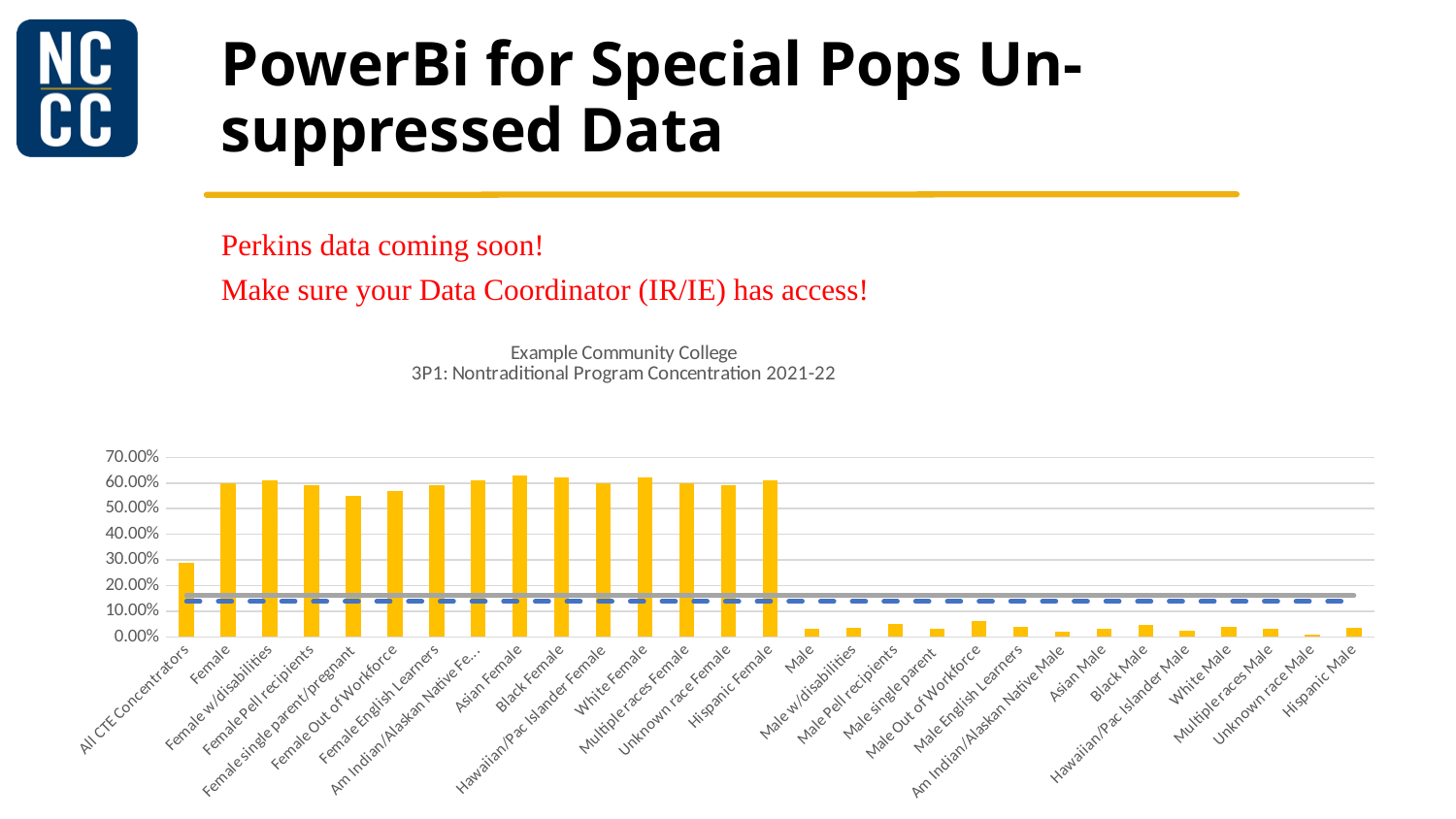
How many categories are plotted along the x axis of the chart? 29 Which is larger, the value for Female or the value for Male? Female Is the value for Male Out of Workforce greater or less than 10.00%? less What is the title of the chart? Example Community College 3P1: Nontraditional Program Concentration 2021-22 Is the value for All CTE Concentrators greater or less than 20.00%? greater Is the value for Male greater or less than 10.00%? less What kind of chart is shown on the slide? combination bar and line chart What is the highest value shown on the y axis of the chart? 70.00% Which is larger, the value for All CTE Concentrators or the value for Female Pell recipients? Female Pell recipients